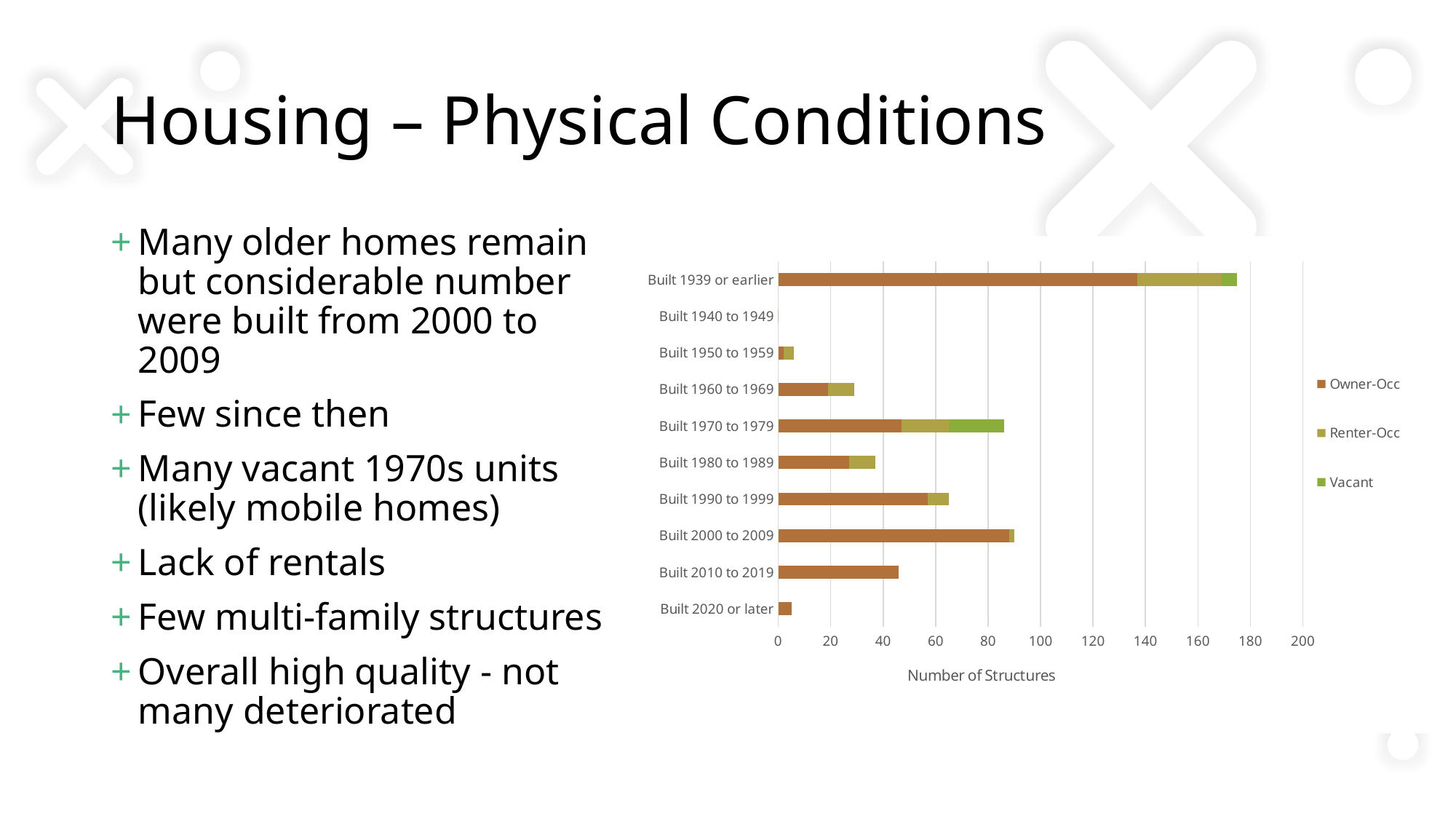
How many building-period categories are shown on the chart? 10 Which has more total structures, Built 2000 to 2009 or Built 2010 to 2019? Built 2000 to 2009 Which building period has the largest Vacant segment? Built 1970 to 1979 What is the label of the horizontal axis of the chart? Number of Structures Is the total number of structures for Built 2000 to 2009 greater or less than 80? greater Is the total number of structures for Built 1960 to 1969 greater or less than 40? less Which building period has the longest total bar? Built 1939 or earlier How many series does the chart legend list? 3 Is the total number of structures for Built 1939 or earlier greater or less than 160? greater Which building period has the shortest total bar? Built 1940 to 1949 What kind of chart is shown on the slide? Bar chart